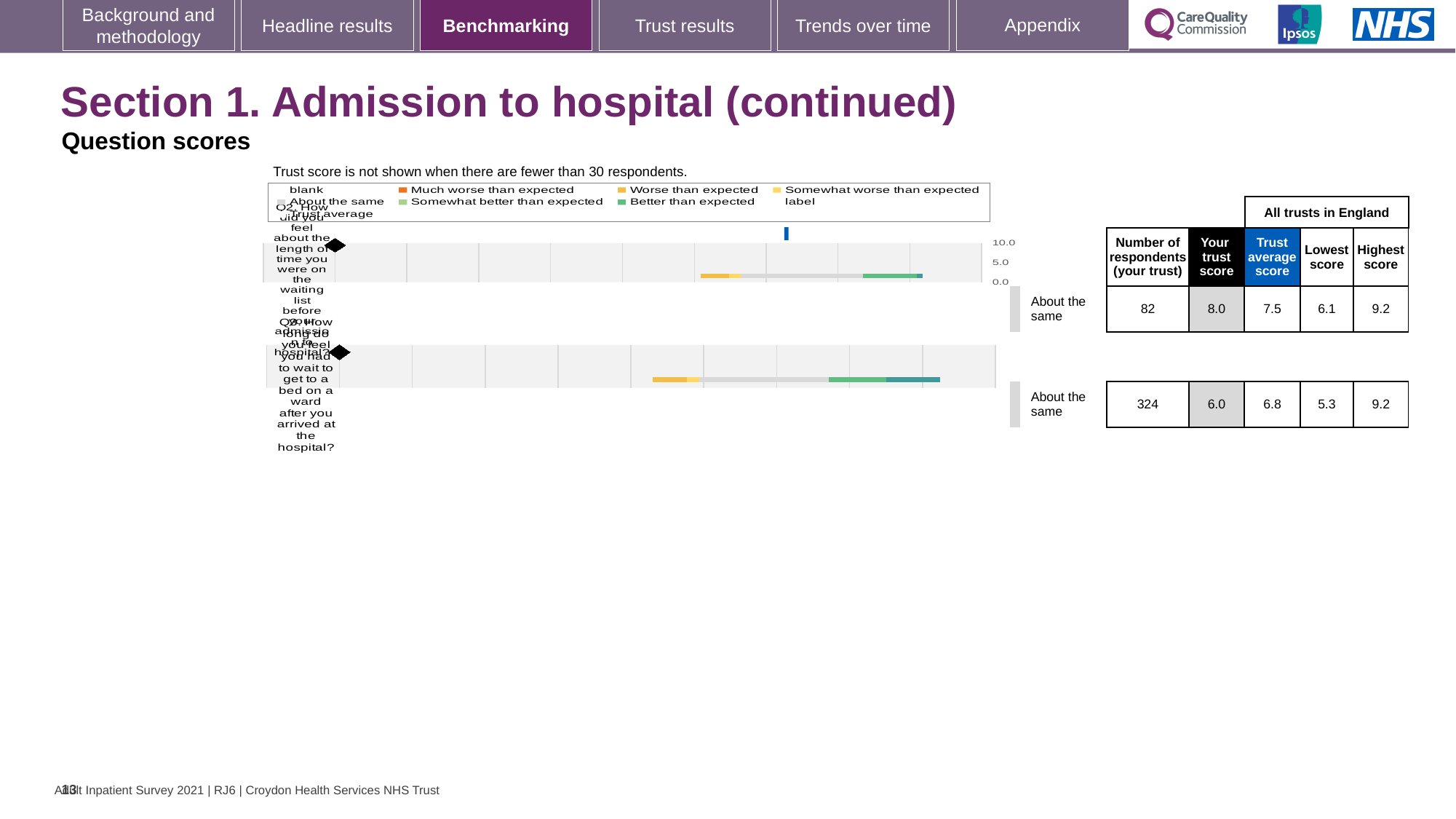
How many respondents answered Q3 for this trust? 324 How many respondents answered Q2 for this trust? 82 Which question has the higher trust score, Q2 or Q3? Q2 What benchmark category is shown for Q2's trust score? About the same What is the lowest score across all trusts in England for Q3? 5.3 What is the trust score for Q3 (how long did you feel you had to wait to get to a bed on a ward)? 6.0 How many questions are plotted on the chart? 2 By how much does the trust score for Q2 exceed the trust average score for Q2? 0.5 By how much is the trust score for Q3 below the trust average score for Q3? 0.8 What is the trust average score across all trusts in England for Q2? 7.5 What is the highest score across all trusts in England for Q3? 9.2 What is the trust score for Q2 (how did you feel about the length of time on the waiting list before admission)? 8.0